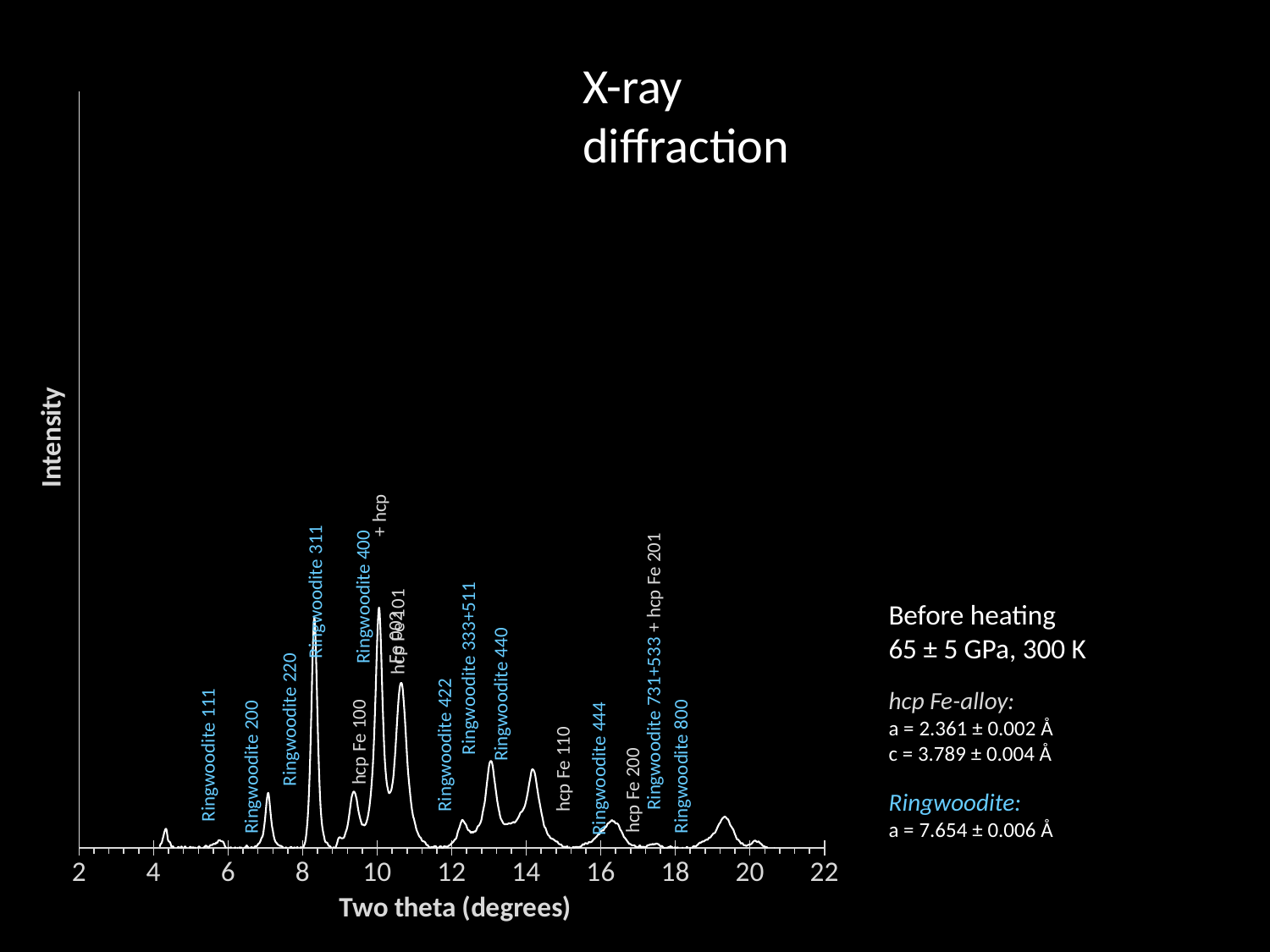
Is the peak labelled hcp Fe 110 located at a two-theta greater or less than 14? greater Is the peak labelled Ringwoodite 220 located at a two-theta greater or less than 8? less How many tick labels are shown on the x axis? 11 What is the lowest tick value shown on the x axis? 2 What is the highest tick value shown on the x axis? 22 Which labelled peak appears at the lowest two-theta value? Ringwoodite 111 Is the peak labelled hcp Fe 100 located at a two-theta greater or less than 10? less What is the title of the chart? X-ray diffraction Which labelled peak appears at the highest two-theta value? Ringwoodite 800 What kind of chart is shown on the slide? line chart What is the label of the x axis? Two theta (degrees)